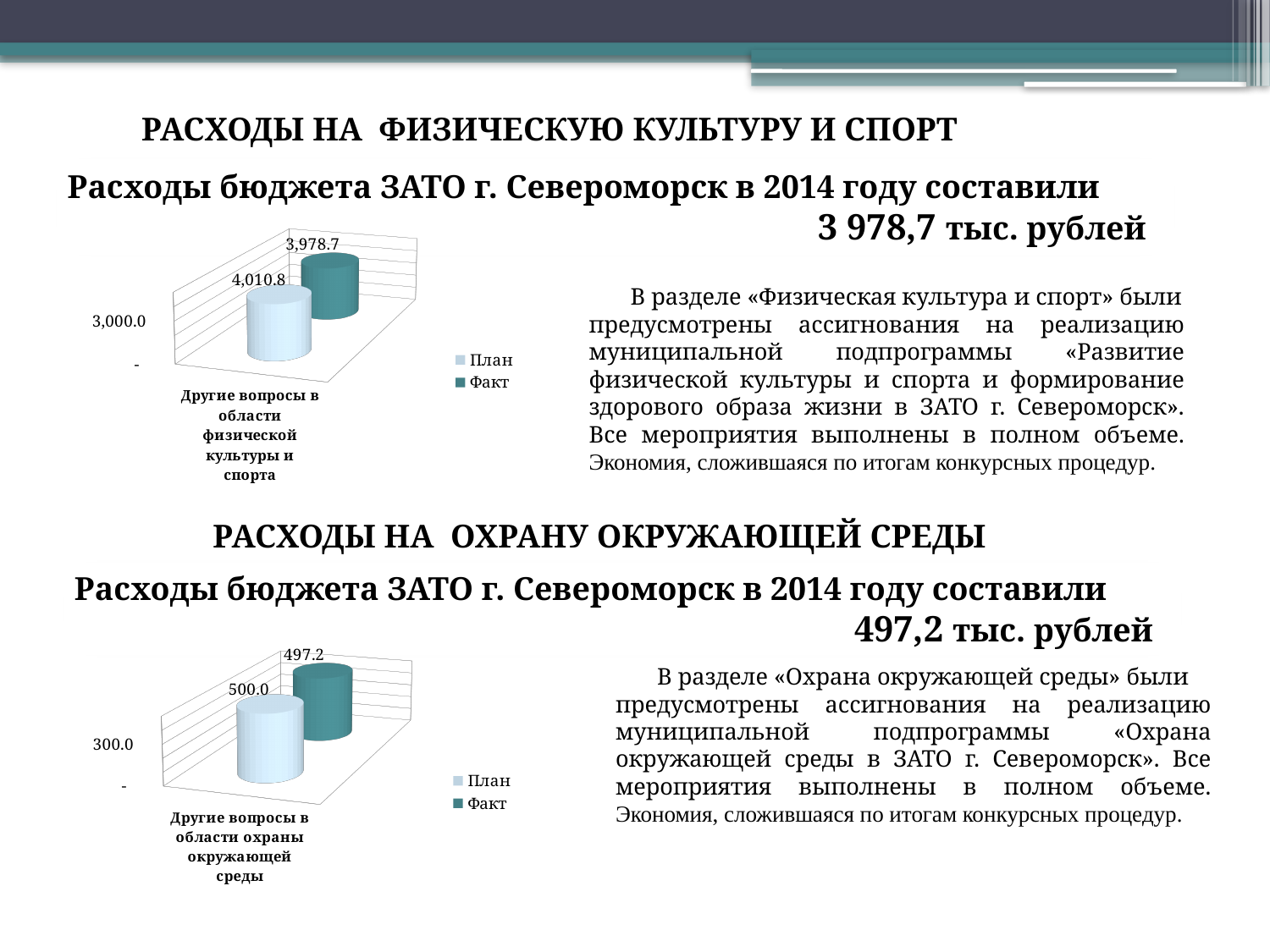
In the top chart, what is the difference between the План and Факт values? 32.1 How many series does the legend of the top chart list? 2 In the bottom chart, what is the value for План? 500.0 In the top chart, what is the value for Факт? 3,978.7 In the bottom chart, which series has the smaller value, План or Факт? Факт What is the category label on the x axis of the top chart? Другие вопросы в области физической культуры и спорта In the bottom chart, what is the value for Факт? 497.2 In the bottom chart, what is the difference between the План and Факт values? 2.8 In the top chart, which series has the larger value, План or Факт? План In the top chart, what is the value for План? 4,010.8 How many categories are shown on the x axis of the bottom chart? 1 What kind of chart is the bottom chart? Bar chart